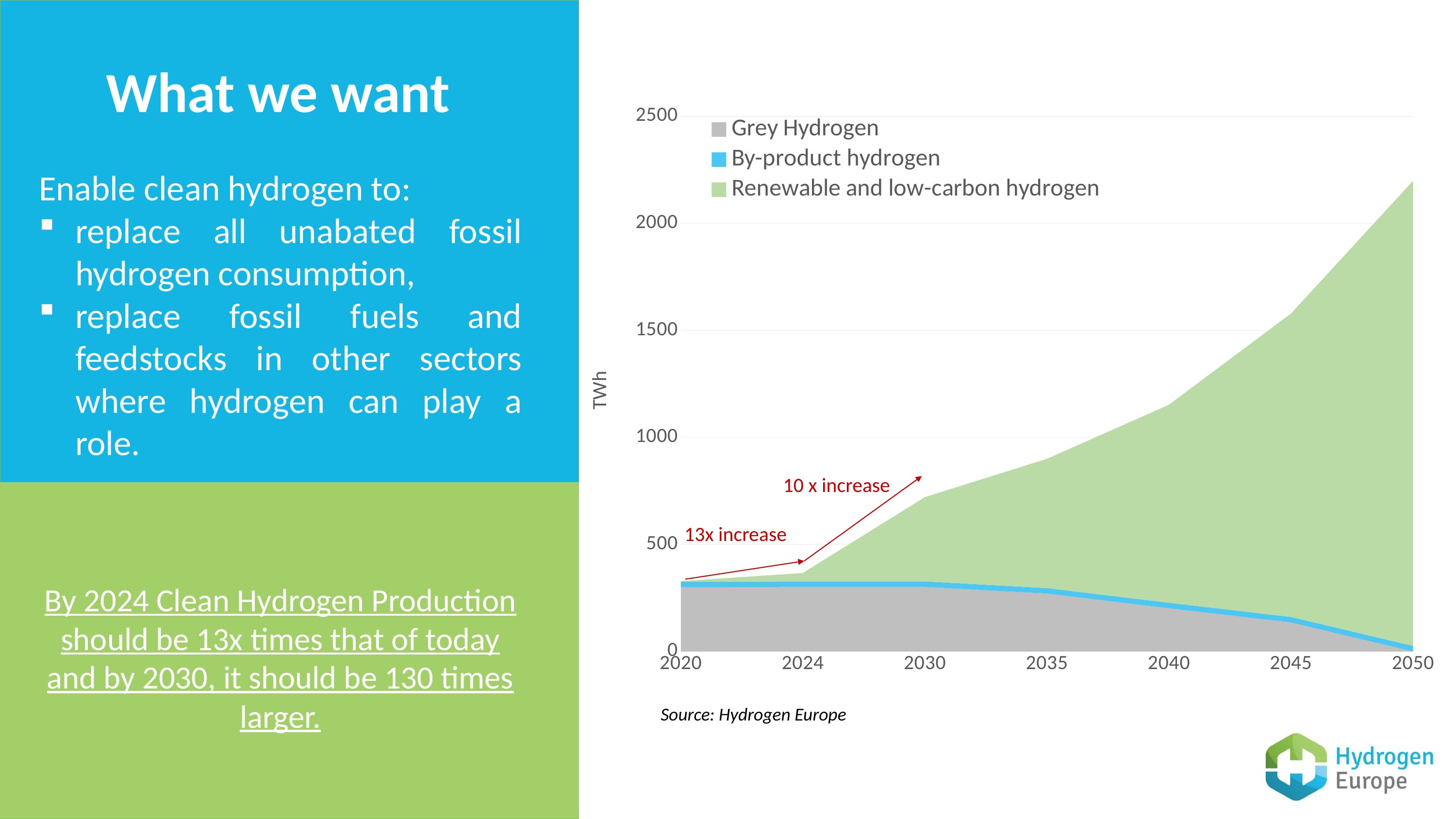
Is the total hydrogen production in 2050 greater or less than 2000 TWh? greater Does the total hydrogen production in the chart rise or fall from 2020 to 2050? Rise Which colour represents Renewable and low-carbon hydrogen in the chart legend? Green Is the total hydrogen production in 2030 greater or less than 500 TWh? greater Which year on the x axis has the highest total hydrogen production? 2050 How many series does the chart legend list? 3 What kind of chart is shown on the slide? Area chart Which year on the x axis has the lowest total hydrogen production? 2020 What unit is shown on the y axis of the chart? TWh How many years are labelled on the x axis of the chart? 7 Is the total hydrogen production in 2040 greater or less than 1000 TWh? greater